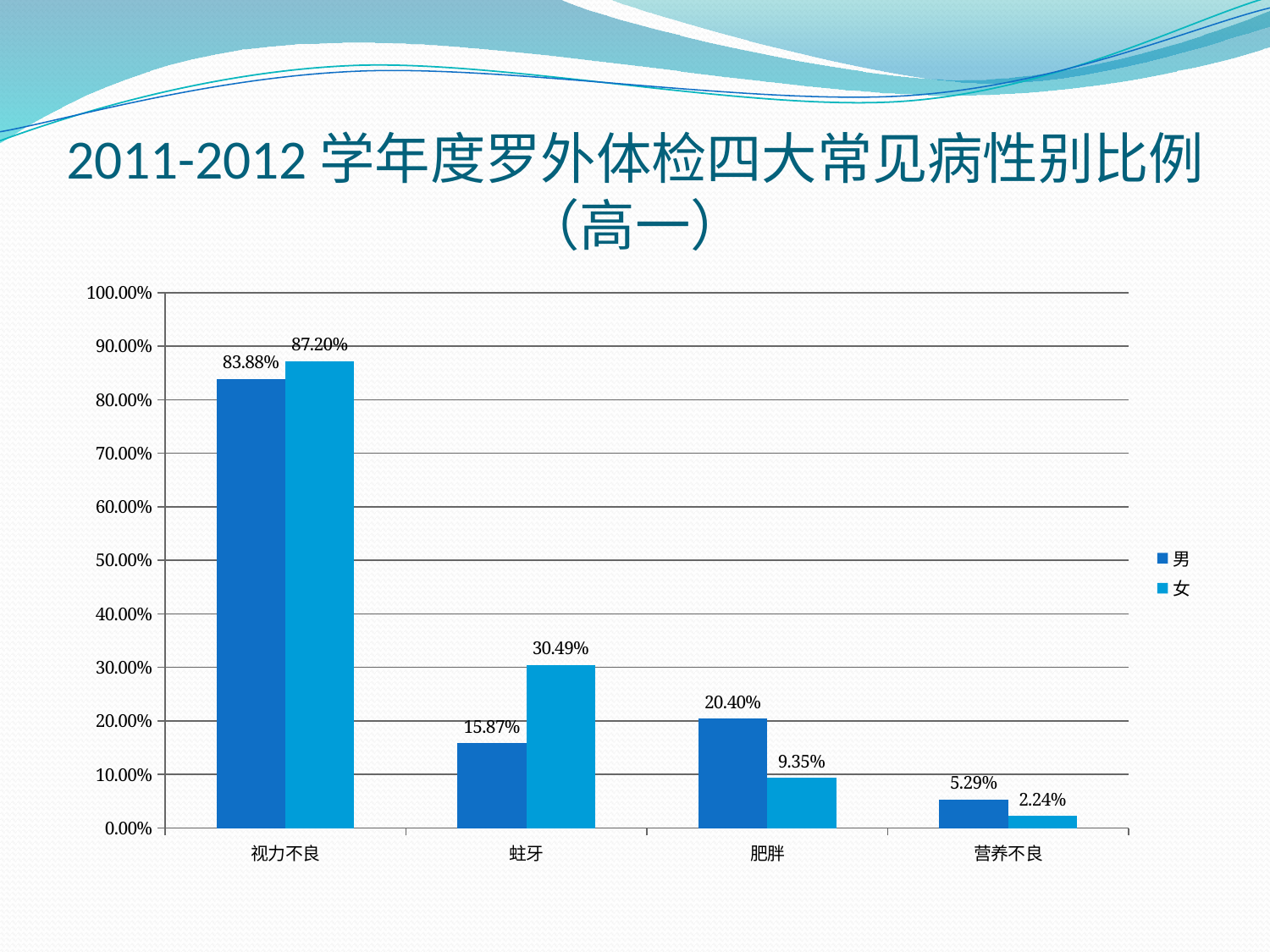
What kind of chart is shown on the slide? bar chart What is the difference between the 女 and 男 values in the 蛀牙 category? 14.62% What is the value for 女 in the 蛀牙 category? 30.49% Is the value for 男 in the 肥胖 category greater or less than 30.00%? less Which category has the highest value for 女? 视力不良 Which category has the lowest value for 男? 营养不良 In the 肥胖 category, which series has the larger value, 男 or 女? 男 What is the value for 男 in the 视力不良 category? 83.88% How many categories are shown on the x axis? 4 How many series does the legend list? 2 What is the difference between the 男 and 女 values in the 营养不良 category? 3.05% What is the value for 女 in the 营养不良 category? 2.24%